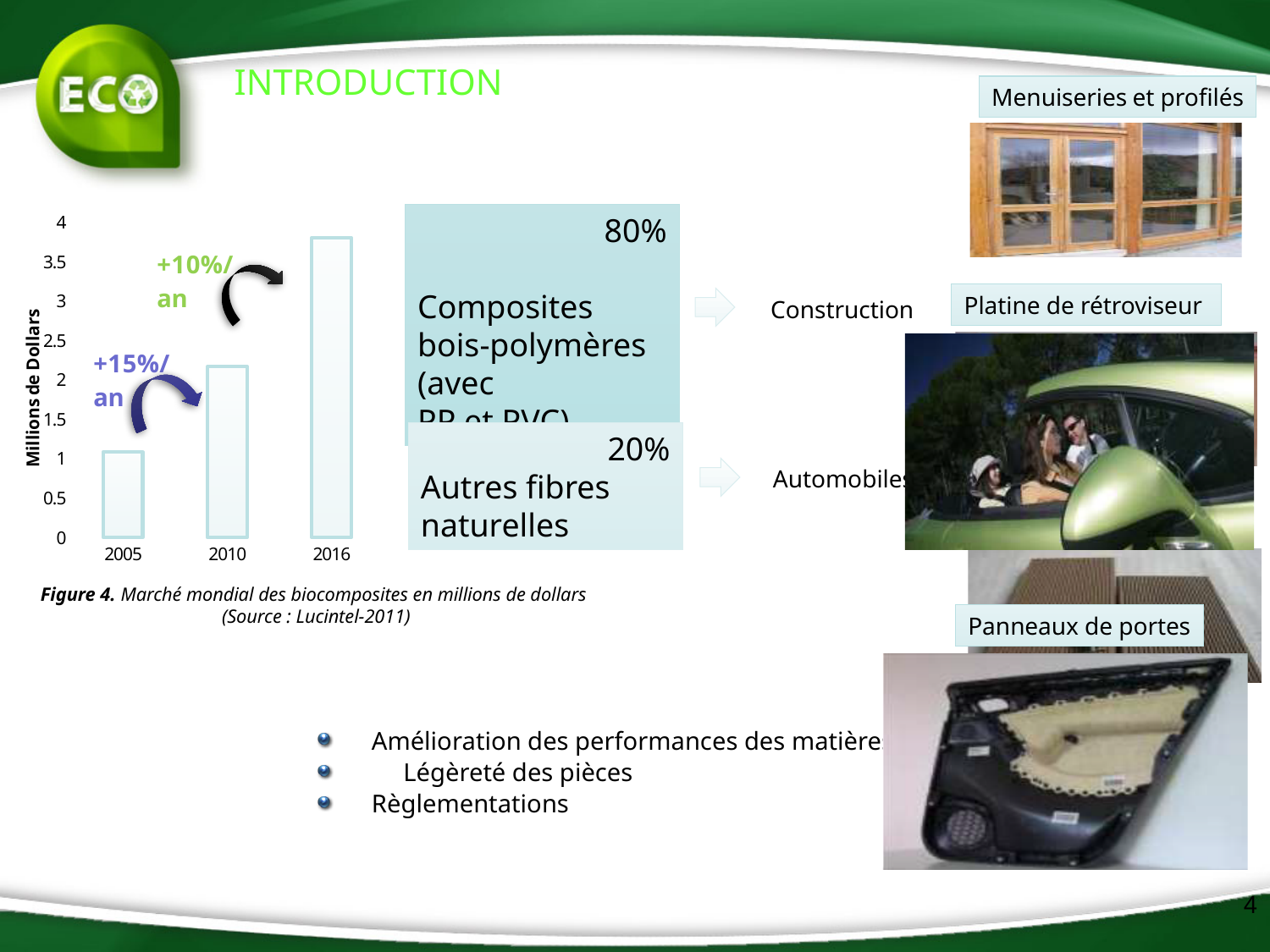
Do the values in the chart rise or fall from 2005 to 2016? rise Is the value for 2005 greater or less than 1.5? less Which is larger, the value for 2010 or the value for 2016? 2016 Which year has the highest bar in the chart? 2016 What annual growth rate is annotated between 2005 and 2010 in the chart? +15%/an How many years are shown on the x axis of the bar chart? 3 What is the label of the y axis of the chart? Millions de Dollars Is the value for 2010 greater or less than 3? less What kind of chart is shown on the slide? bar chart Is the value for 2016 greater or less than 3.5? greater Which year has the lowest bar in the chart? 2005